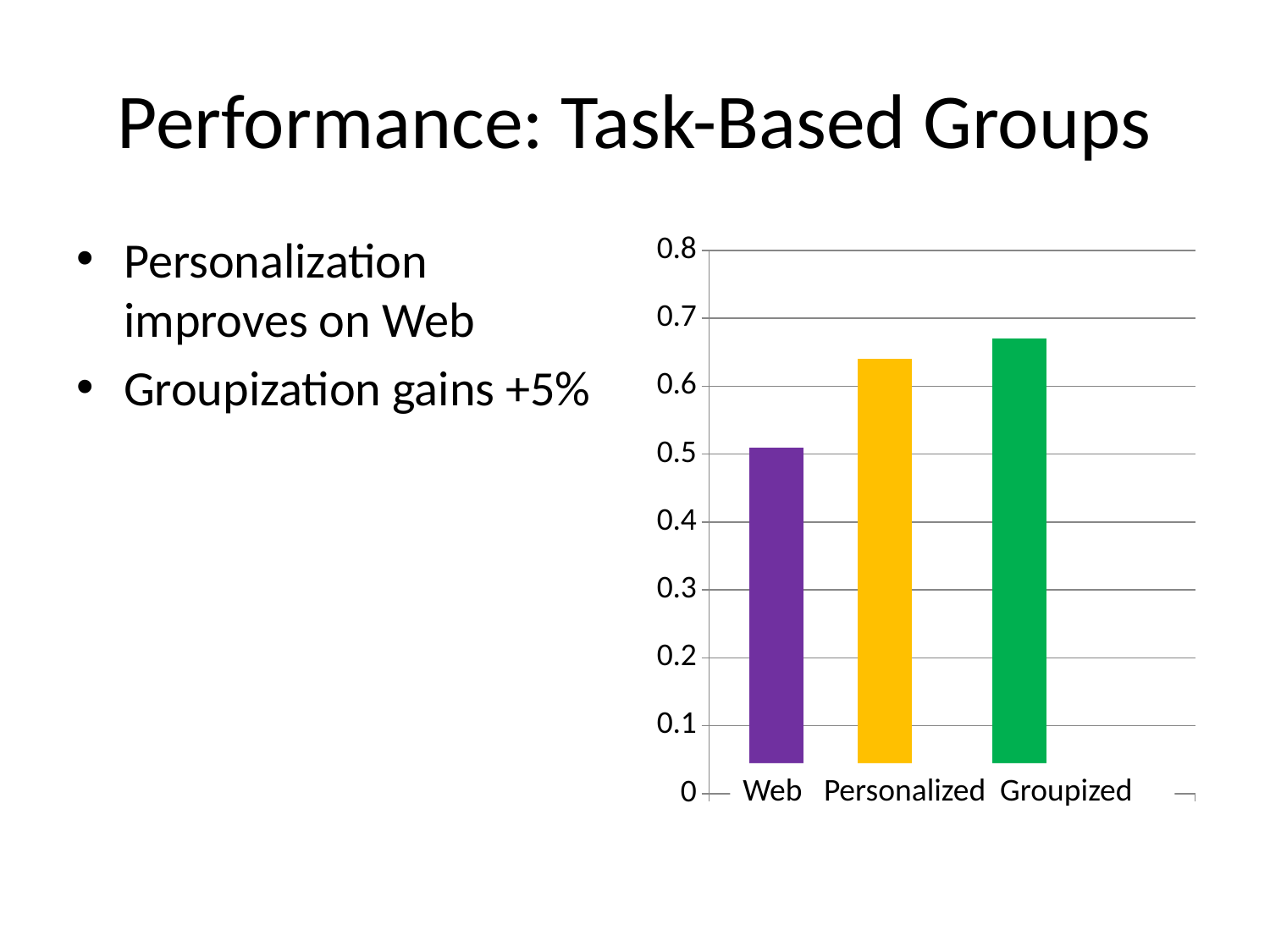
How many categories are shown on the x axis of the chart? 3 Which is larger, the value for Web or the value for Personalized? Personalized What is the highest value shown on the y axis of the chart? 0.8 Is the value for Web greater or less than 0.6? less What colour is the bar for Groupized? green Do the bar values rise or fall from left to right across the x axis? rise Is the value for Personalized greater or less than 0.6? greater Which category has the lowest bar in the chart? Web Is the value for Groupized greater or less than 0.7? less Which category has the highest bar in the chart? Groupized What kind of chart is shown on the slide? bar chart